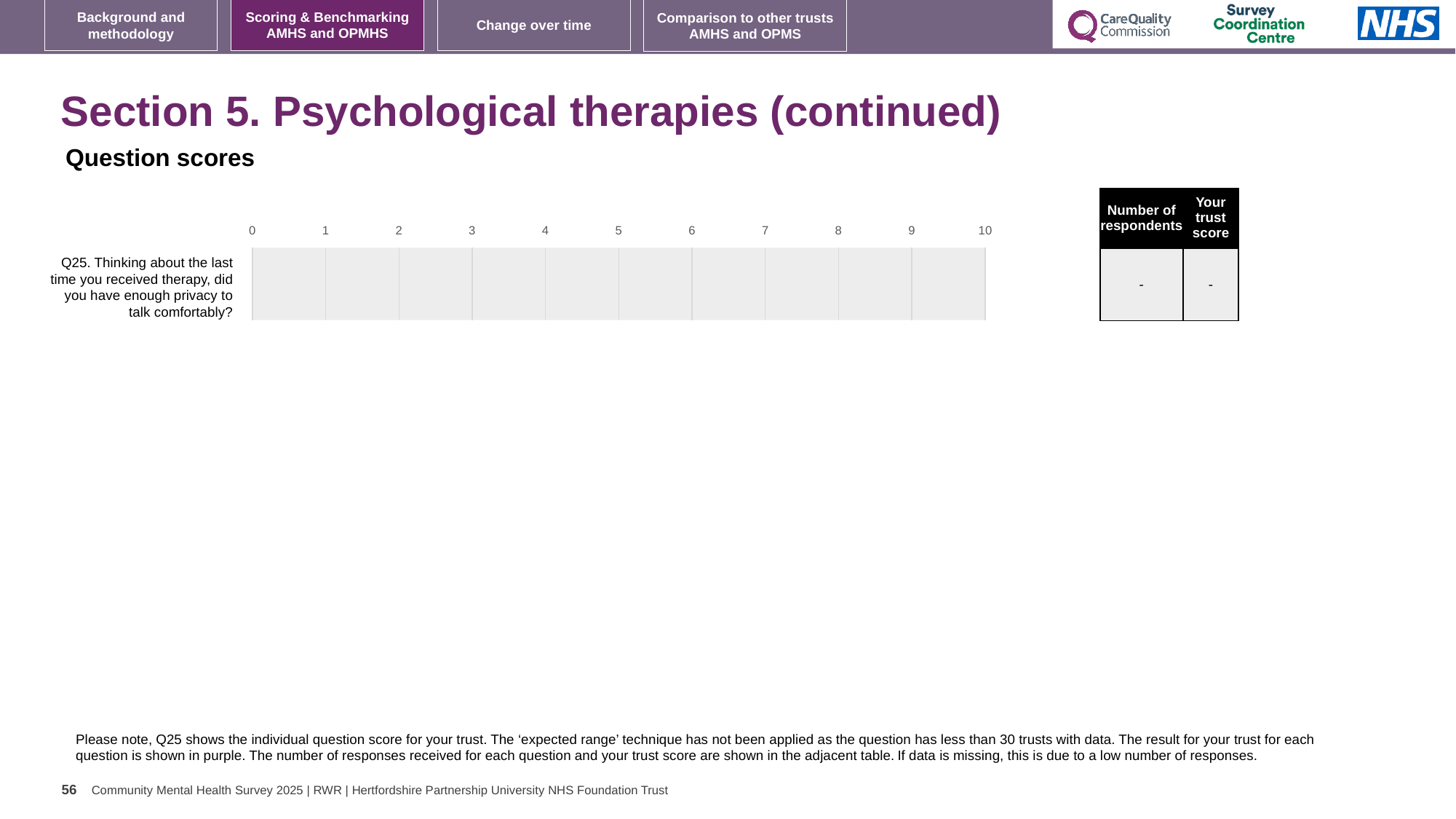
What value is shown in the 'Your trust score' column of the table for Q25? - How many questions (categories) are listed on the chart's axis? 1 Which question number is plotted on the chart? Q25 What kind of chart is shown on the slide? bar chart What is the highest value shown on the chart's numeric axis? 10 What is the lowest value shown on the chart's numeric axis? 0 What value is shown in the 'Number of respondents' column of the table for Q25? -